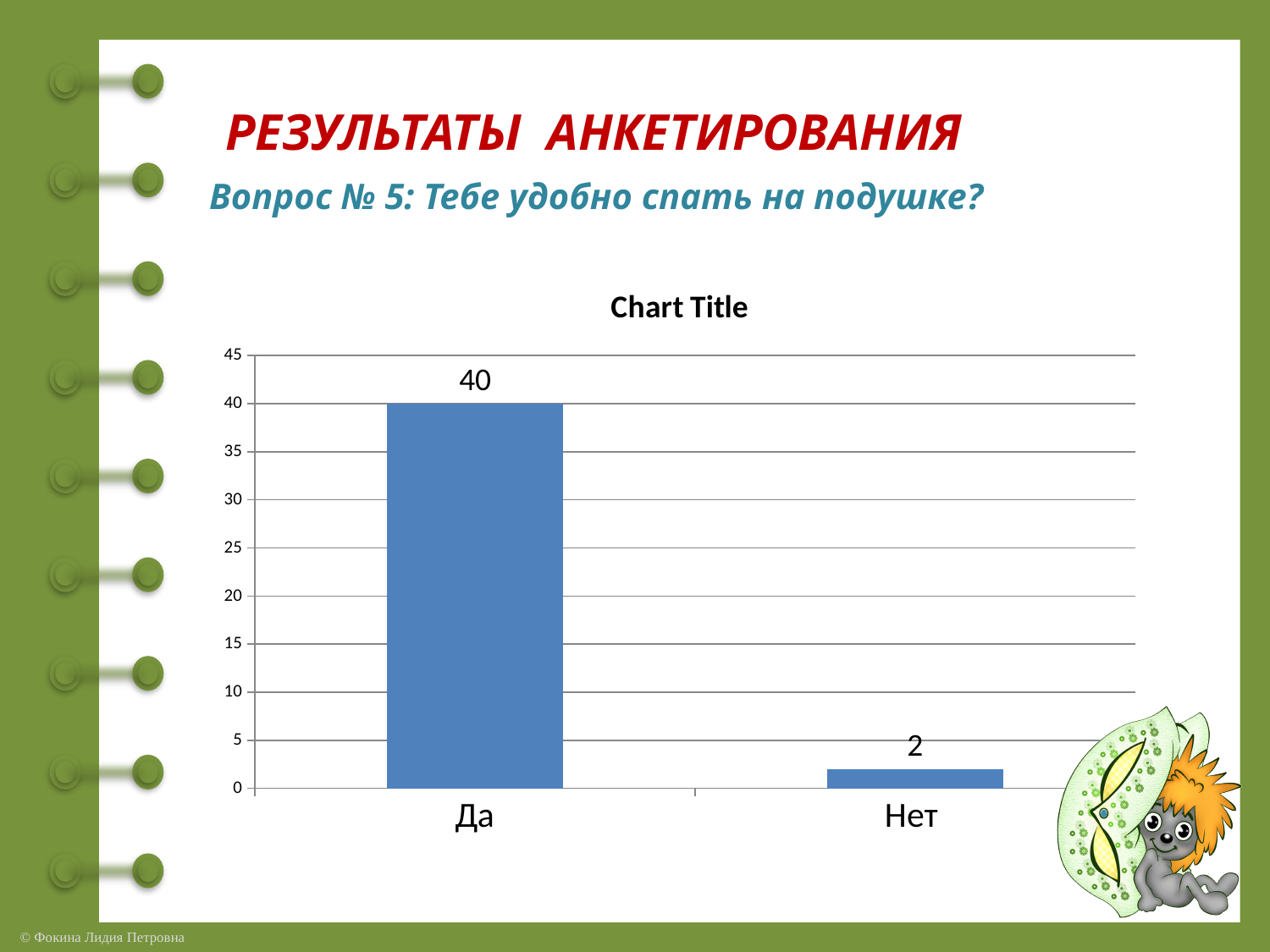
Which category has the highest value? Да What kind of chart is shown on the slide? bar chart Is the value for Нет greater or less than 5? less What is the difference between the values for Да and Нет? 38 Which is larger, the value for Да or the value for Нет? Да How many categories are shown on the x axis? 2 What is the highest value shown on the vertical axis? 45 Is the value for Да greater or less than 35? greater What is the value for Да? 40 What is the title printed above the chart? Chart Title Which category has the lowest value? Нет What is the value for Нет? 2